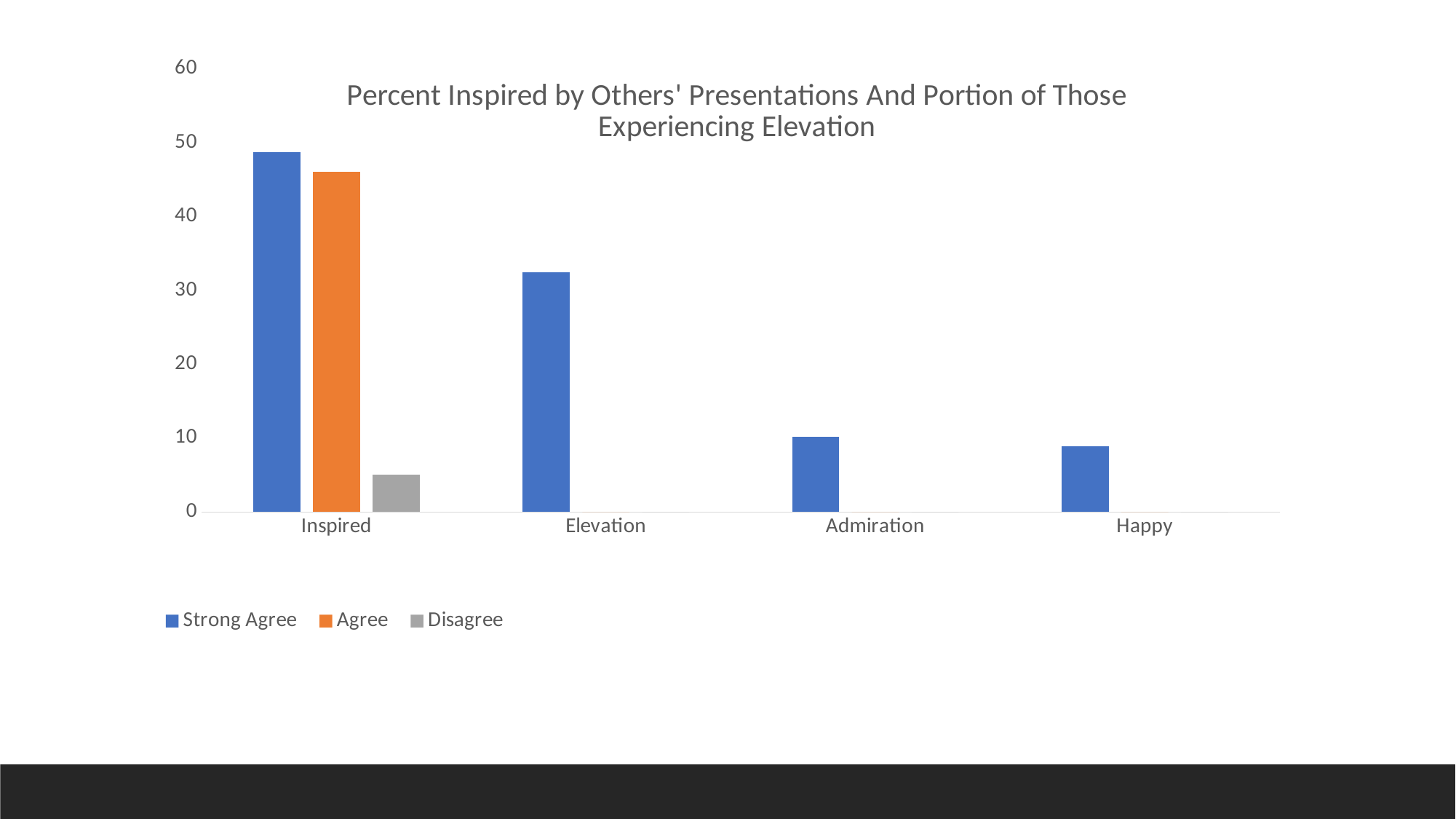
How many categories are shown on the x axis? 4 What kind of chart is shown on the slide? bar chart Is the Strong Agree value for Elevation greater or less than 30? greater Which is larger, the Strong Agree value for Elevation or for Admiration? Elevation What is the title of the chart? Percent Inspired by Others' Presentations And Portion of Those Experiencing Elevation Is the Strong Agree value for Happy greater or less than 20? less Is the Strong Agree value for Inspired greater or less than 40? greater Which category has the highest Strong Agree value? Inspired How many series does the legend list? 3 Which series is shown in orange in the legend? Agree